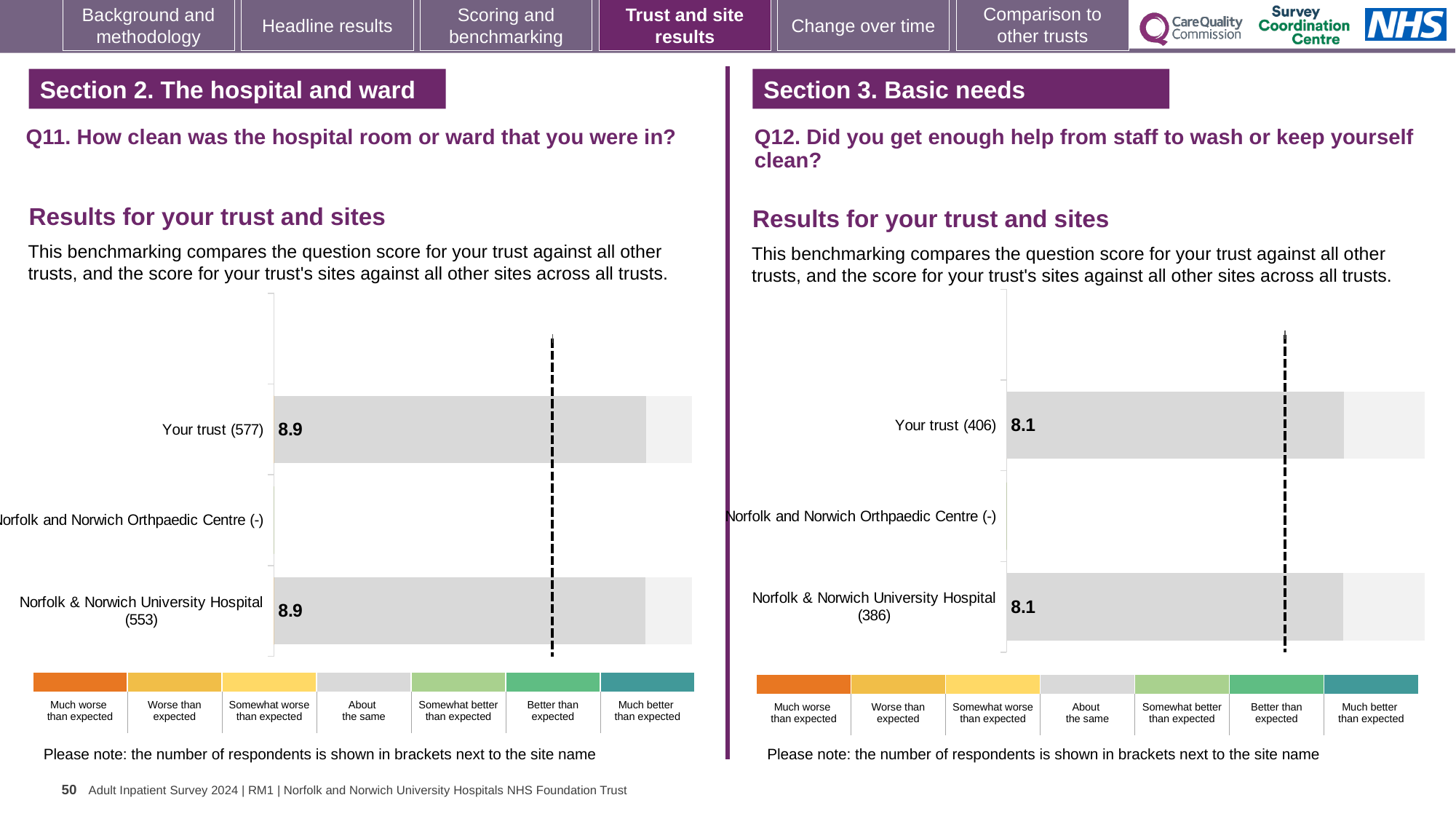
In the Q12 chart on the right, what is the difference between the score for Your trust (406) and the score for Norfolk & Norwich University Hospital (386)? 0 In the Q12 chart on the right, how many respondents are shown in brackets for Your trust? 406 In the Q11 chart on the left, what is the score for Norfolk & Norwich University Hospital (553)? 8.9 In the Q11 chart on the left, which category has no bar plotted? Norfolk and Norwich Orthpaedic Centre (-) How many categories are listed on the vertical axis of the Q12 chart on the right? 3 What kind of chart is the Q11 chart on the left? Bar chart In the Q12 chart on the right, what is the score for Norfolk & Norwich University Hospital (386)? 8.1 In the Q12 chart on the right, what is the score for Your trust (406)? 8.1 Which is larger: the Your trust score in the Q11 chart on the left or the Your trust score in the Q12 chart on the right? Q11 chart on the left In the Q11 chart on the left, what is the score for Your trust (577)? 8.9 How many categories are listed on the vertical axis of the Q11 chart on the left? 3 In the Q11 chart on the left, what is the difference between the score for Your trust (577) and the score for Norfolk & Norwich University Hospital (553)? 0